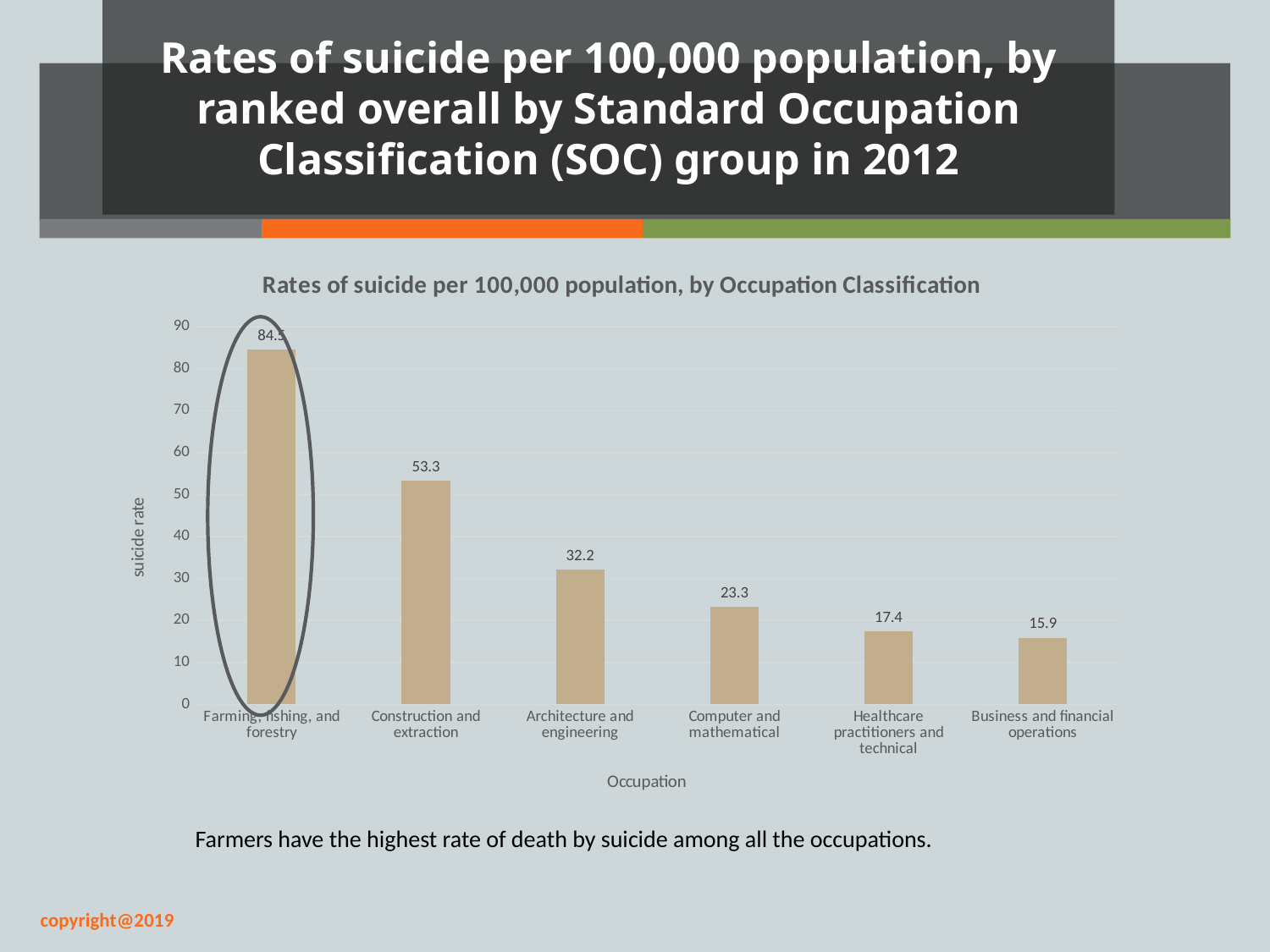
What is the suicide rate for Computer and mathematical? 23.3 Is the value for Farming, fishing, and forestry greater or less than 80? greater What type of chart is shown on the slide? Bar chart What is the suicide rate for Healthcare practitioners and technical? 17.4 What is the suicide rate for Business and financial operations? 15.9 What is the suicide rate for Architecture and engineering? 32.2 Which occupation has the highest suicide rate? Farming, fishing, and forestry What is the suicide rate for Construction and extraction? 53.3 What is the difference between the suicide rates for Construction and extraction and Architecture and engineering? 21.1 How many occupation categories are shown in the chart? 6 Which has a higher suicide rate, Computer and mathematical or Healthcare practitioners and technical? Computer and mathematical Which occupation has the lowest suicide rate? Business and financial operations